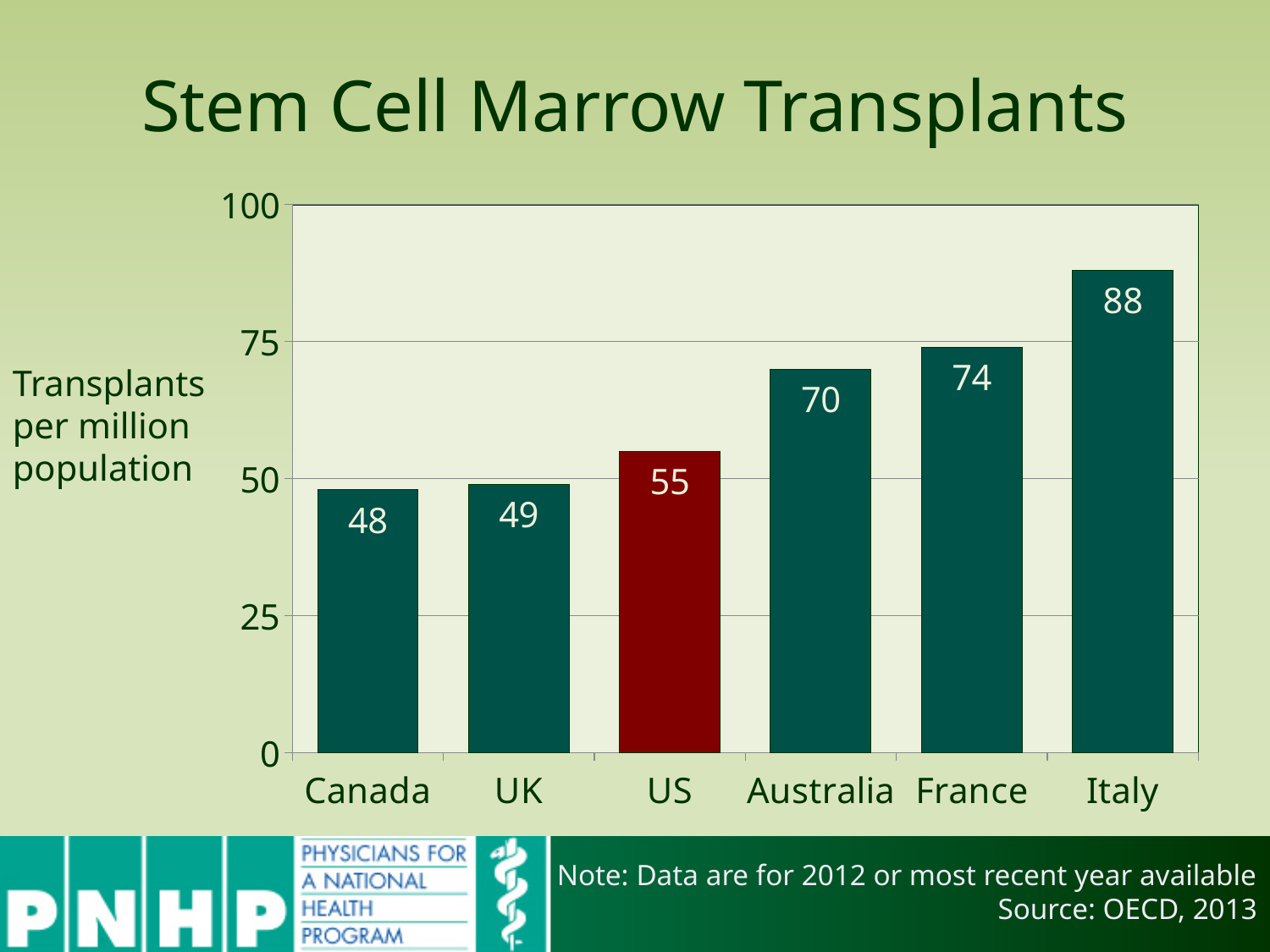
Which bar is coloured differently (red) from the others? US Which country has the lowest number of transplants per million population? Canada What is the value for the US? 55 What kind of chart is shown on the slide? bar chart What is the value for Australia? 70 Which country has the highest number of transplants per million population? Italy How many countries are shown on the chart? 6 What is the difference between the values for Italy and the US? 33 Which is larger, the value for France or the value for the US? France What is the difference between the values for France and Australia? 4 What is the value for Canada? 48 Is the value for Italy greater or less than 75? greater